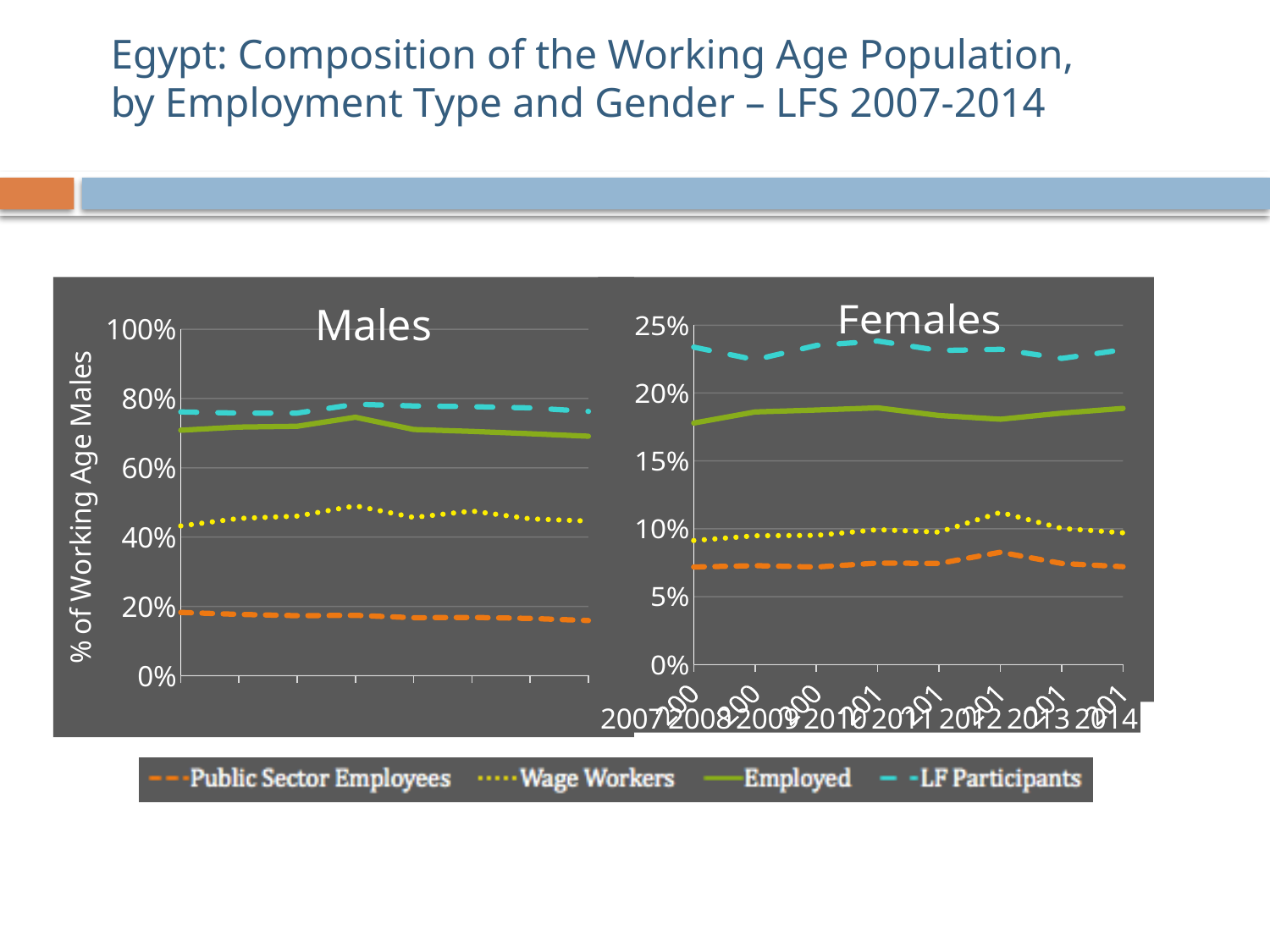
In the Females chart, is the value for Public Sector Employees greater or less than 10%? less In the Females chart, is the value for LF Participants greater or less than 20%? greater What kind of chart is the Males chart? line chart In the Females chart, which series has the lowest values? Public Sector Employees In the Males chart, which series has the highest values? LF Participants In the Males chart, which series is larger, Wage Workers or Public Sector Employees? Wage Workers In the Males chart, is the value for Wage Workers greater or less than 40%? greater In the Females chart, how many years are shown on the x axis? 8 In the Females chart, which series has the highest values? LF Participants In the Males chart, which series has the lowest values? Public Sector Employees How many series does the legend list? 4